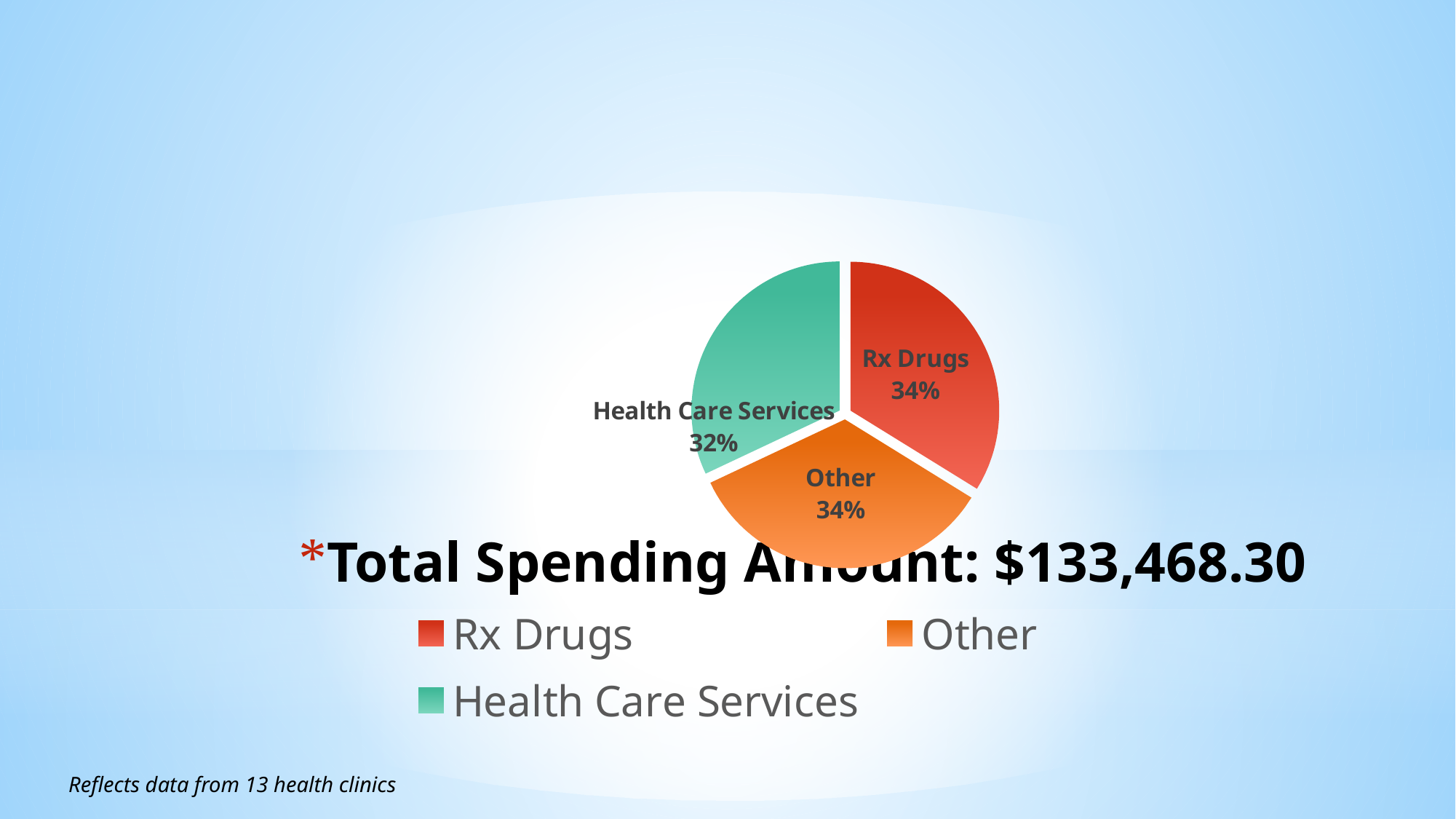
What share of the pie does Rx Drugs represent? 34% How many categories are shown in the pie chart? 3 What share of the pie does Other represent? 34% Which category has the smallest slice of the pie? Health Care Services Which is larger, the Rx Drugs slice or the Health Care Services slice? Rx Drugs What total spending amount is stated on the slide? $133,468.30 What is the difference in percentage points between the Rx Drugs slice and the Health Care Services slice? 2 percentage points How many entries does the legend list? 3 What colour is the Health Care Services slice? Green What kind of chart is shown on the slide? Pie chart What share of the pie does Health Care Services represent? 32%